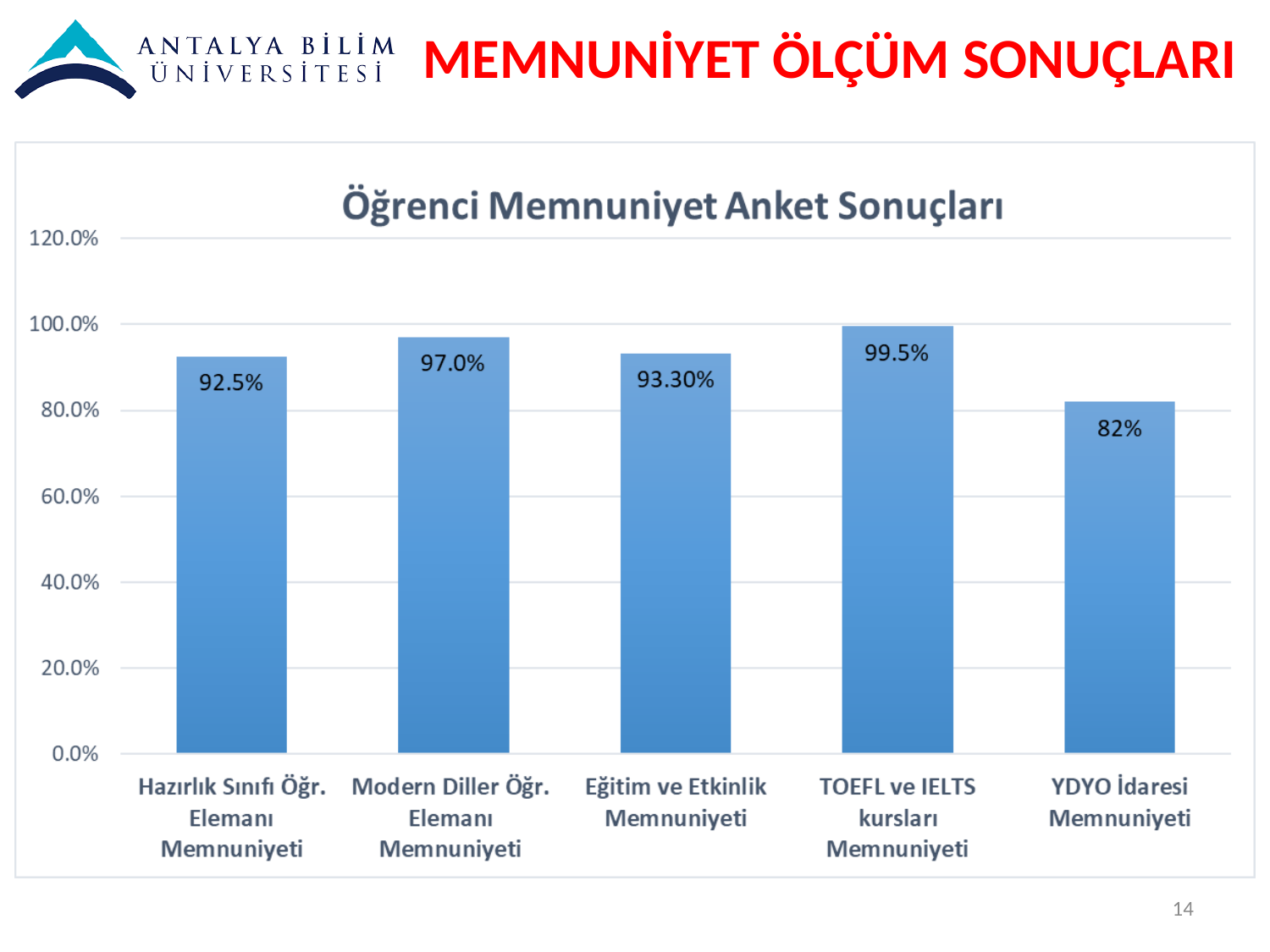
Which category has the highest value? TOEFL ve IELTS kursları Memnuniyeti What kind of chart is shown on the slide? Bar chart Which is larger, the value for Modern Diller Öğr. Elemanı Memnuniyeti or the value for Hazırlık Sınıfı Öğr. Elemanı Memnuniyeti? Modern Diller Öğr. Elemanı Memnuniyeti What is the value for Modern Diller Öğr. Elemanı Memnuniyeti? 97.0% Which category has the lowest value? YDYO İdaresi Memnuniyeti What is the value for Hazırlık Sınıfı Öğr. Elemanı Memnuniyeti? 92.5% What is the value for YDYO İdaresi Memnuniyeti? 82% How many categories are shown in the chart? 5 What is the difference between the values for TOEFL ve IELTS kursları Memnuniyeti and YDYO İdaresi Memnuniyeti? 17.5% What is the title of the chart? Öğrenci Memnuniyet Anket Sonuçları What is the value for Eğitim ve Etkinlik Memnuniyeti? 93.30% What is the value for TOEFL ve IELTS kursları Memnuniyeti? 99.5%